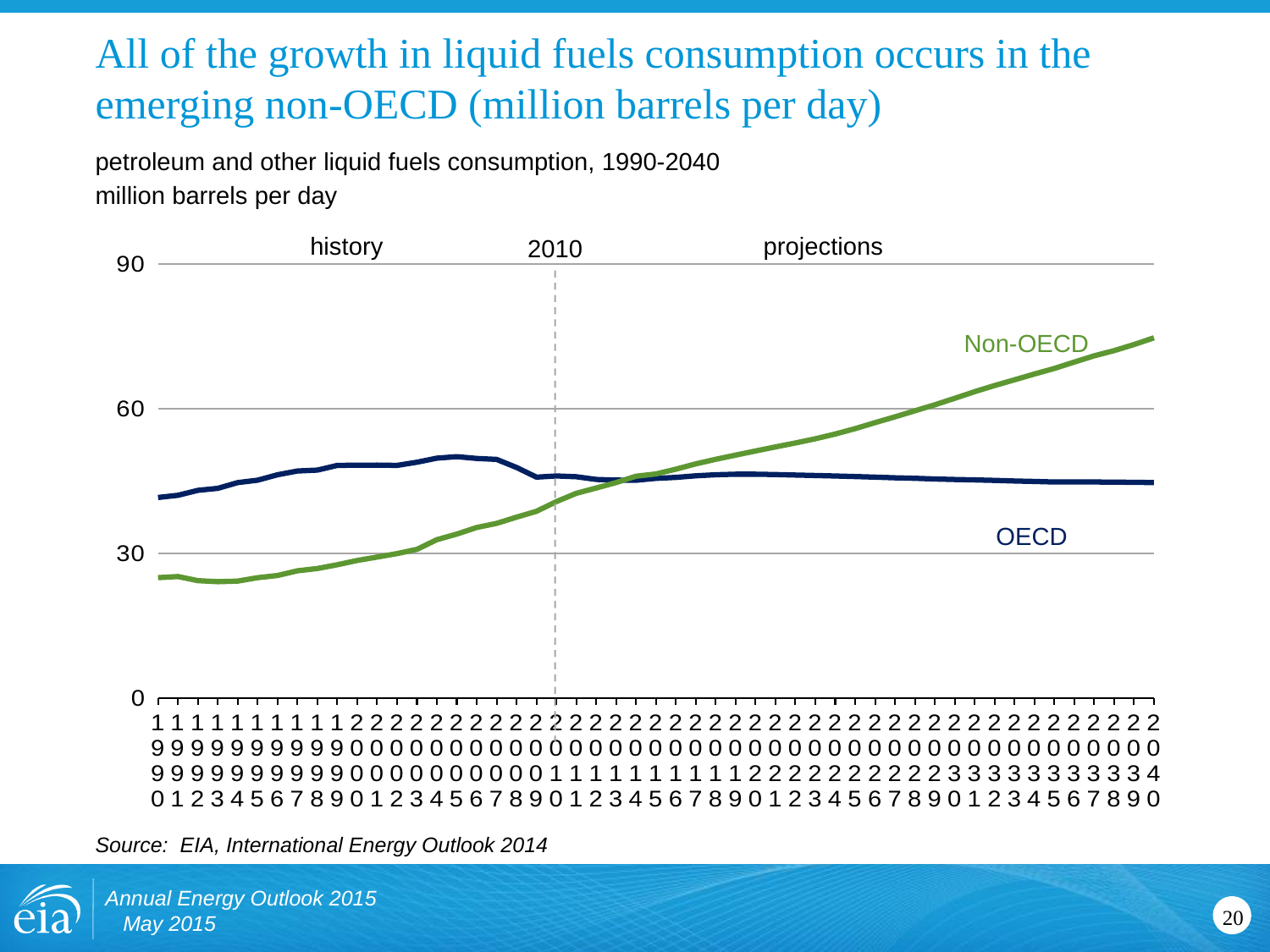
In 1990, which series has the higher consumption, OECD or Non-OECD? OECD Is the Non-OECD value in 2010 greater or less than 30? greater How many series are plotted on the chart? 2 Does Non-OECD liquid fuels consumption rise or fall from 1990 to 2040? rise Is the OECD value in 2040 greater or less than 60? less What year does the dashed vertical line separating history from projections mark? 2010 Is the Non-OECD value in 1990 greater or less than 30? less In 2040, which series has the higher consumption, OECD or Non-OECD? Non-OECD What kind of chart is shown on the slide? line chart Which series is drawn in green? Non-OECD